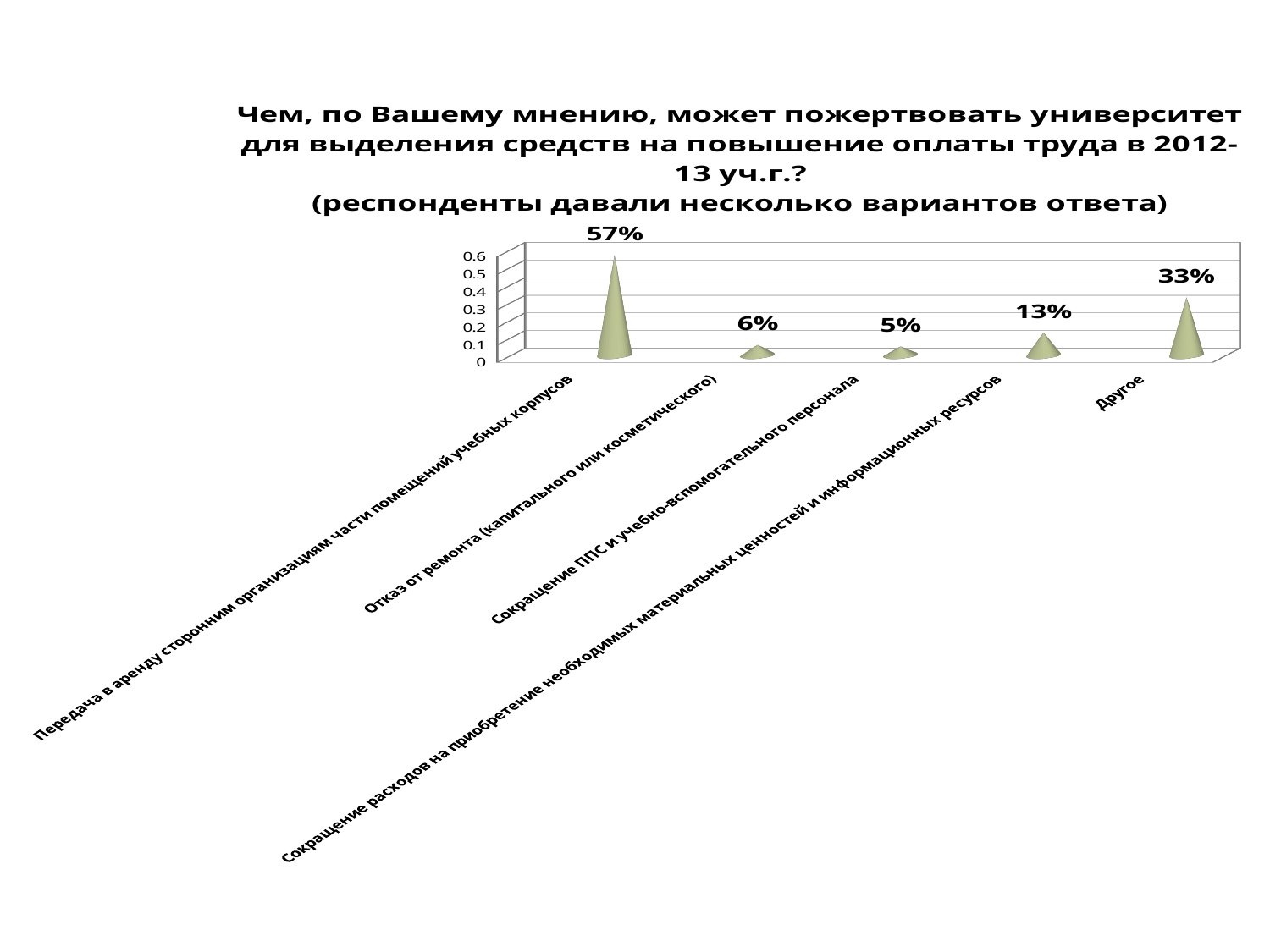
What is the difference between the values for "Передача в аренду сторонним организациям части помещений учебных корпусов" and "Другое"? 24% What is the value for "Отказ от ремонта (капитального или косметического)"? 6% What is the value for "Передача в аренду сторонним организациям части помещений учебных корпусов"? 57% What is the value for "Сокращение расходов на приобретение необходимых материальных ценностей и информационных ресурсов"? 13% What is the value for "Сокращение ППС и учебно-вспомогательного персонала"? 5% How many categories are shown on the chart? 5 What is the highest tick value shown on the vertical axis? 0.6 What is the value for "Другое"? 33% Which category has the lowest value? Сокращение ППС и учебно-вспомогательного персонала Which category has the highest value? Передача в аренду сторонним организациям части помещений учебных корпусов Which is larger: the value for "Другое" or the value for "Сокращение расходов на приобретение необходимых материальных ценностей и информационных ресурсов"? Другое What kind of chart is shown on the slide? Bar chart